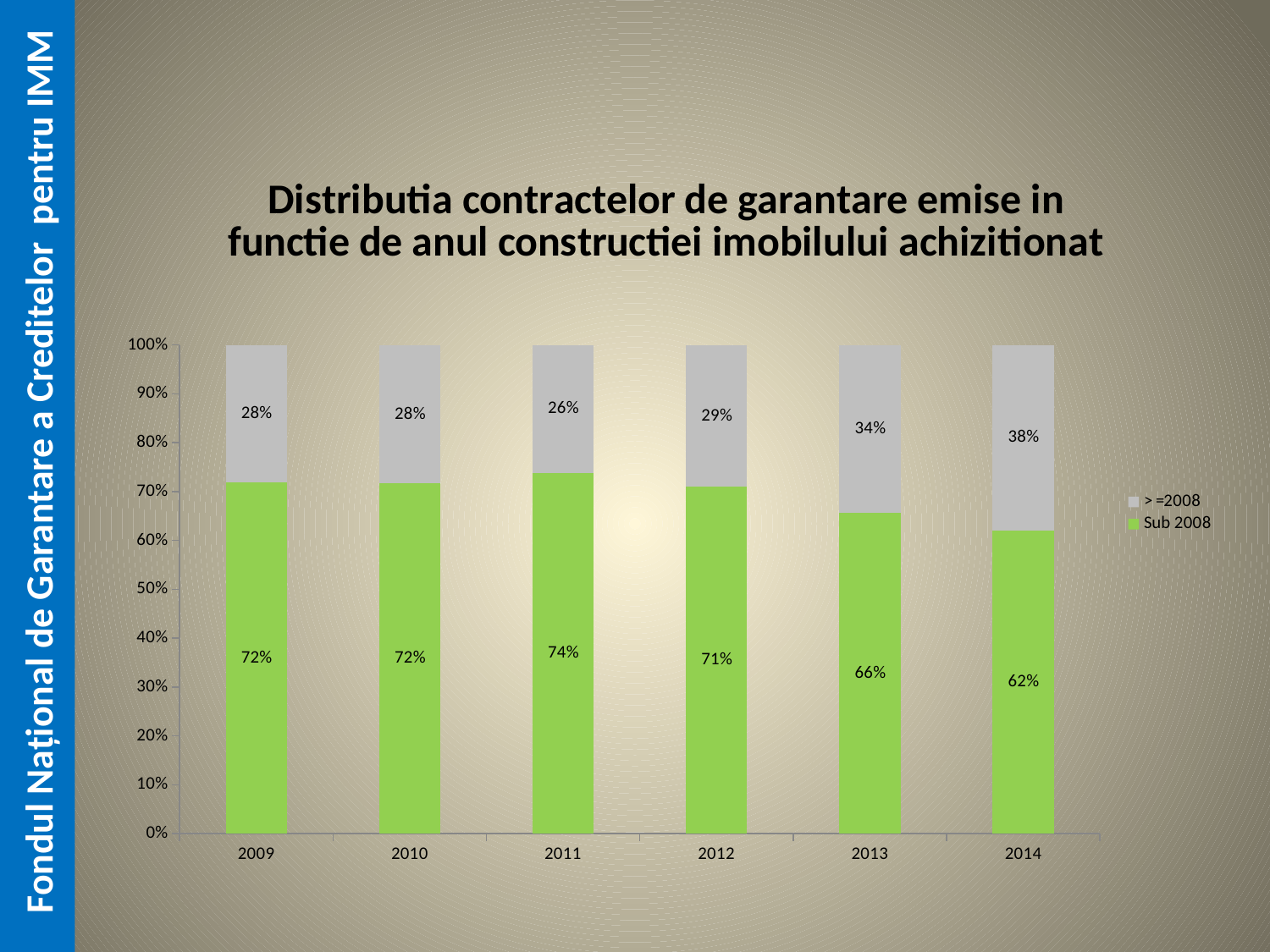
Which year has the highest value for "Sub 2008"? 2011 What kind of chart is shown on the slide? Stacked bar chart Which year has the highest value for ">=2008"? 2014 What is the value for "Sub 2008" in 2013? 66% What is the value for ">=2008" in 2014? 38% Does the ">=2008" share rise or fall from 2012 to 2014? Rise What is the value for "Sub 2008" in 2011? 74% How many series does the legend list? 2 How many years are shown on the x axis? 6 Which year has the lowest value for "Sub 2008"? 2014 Is the ">=2008" value larger in 2013 or in 2012? 2013 What is the difference between the "Sub 2008" values for 2009 and 2014? 10%